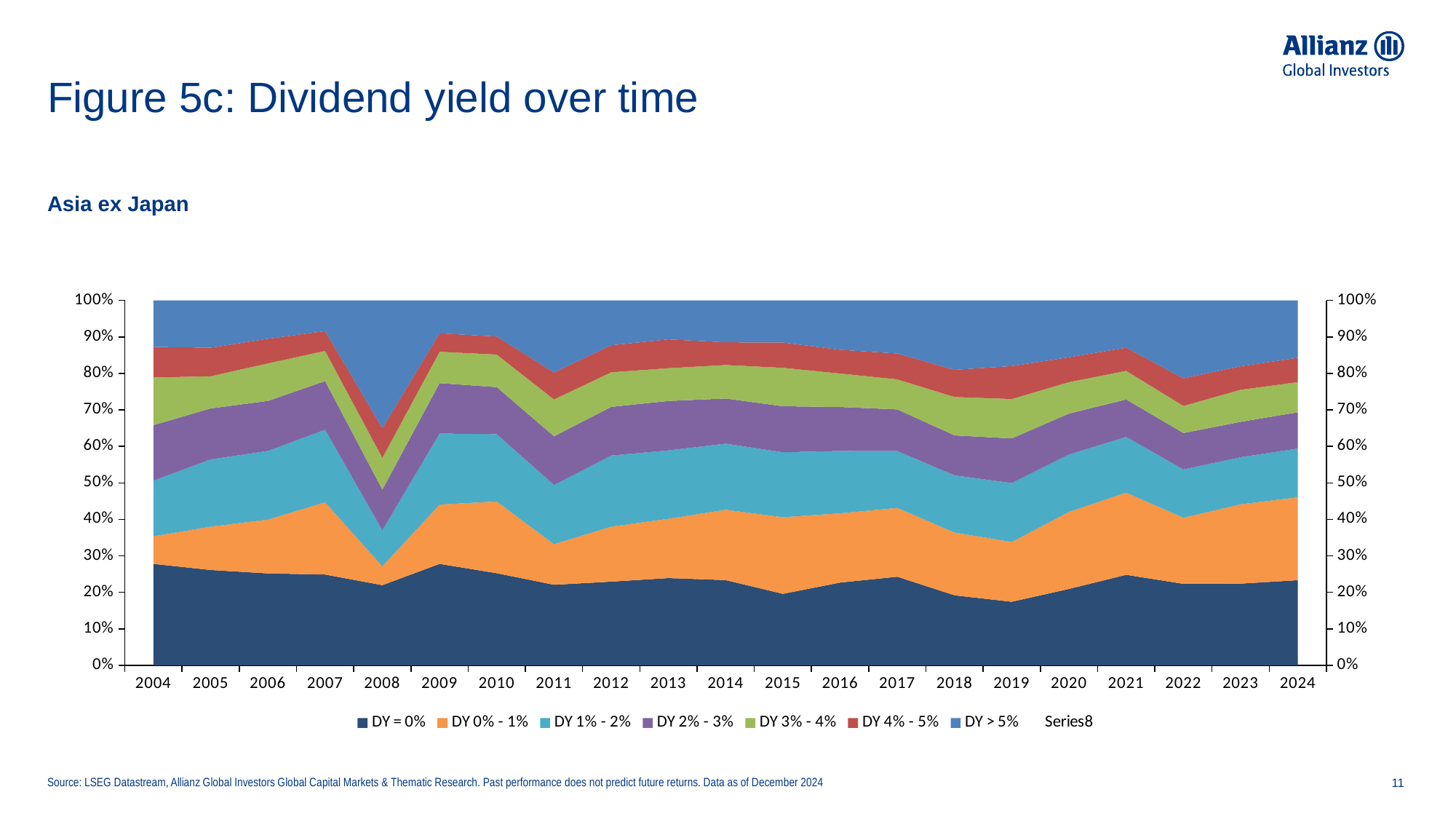
Is the share for DY = 0% in 2004 greater or less than 20%? greater What kind of chart is shown on the slide? Stacked area chart Which is larger, the DY = 0% share in 2008 or in 2009? 2009 Is the share for DY = 0% in 2019 greater or less than 20%? less How many entries does the chart's legend list? 8 Does the DY = 0% share rise or fall from 2004 to 2008? fall How many years are plotted along the x axis of the chart? 21 Which legend entry is shown in dark navy at the bottom of the stacked areas? DY = 0% Is the share for DY = 0% in 2004 greater or less than 30%? less Which region does the chart cover, according to the subtitle? Asia ex Japan Which is larger, the DY = 0% share in 2004 or in 2019? 2004